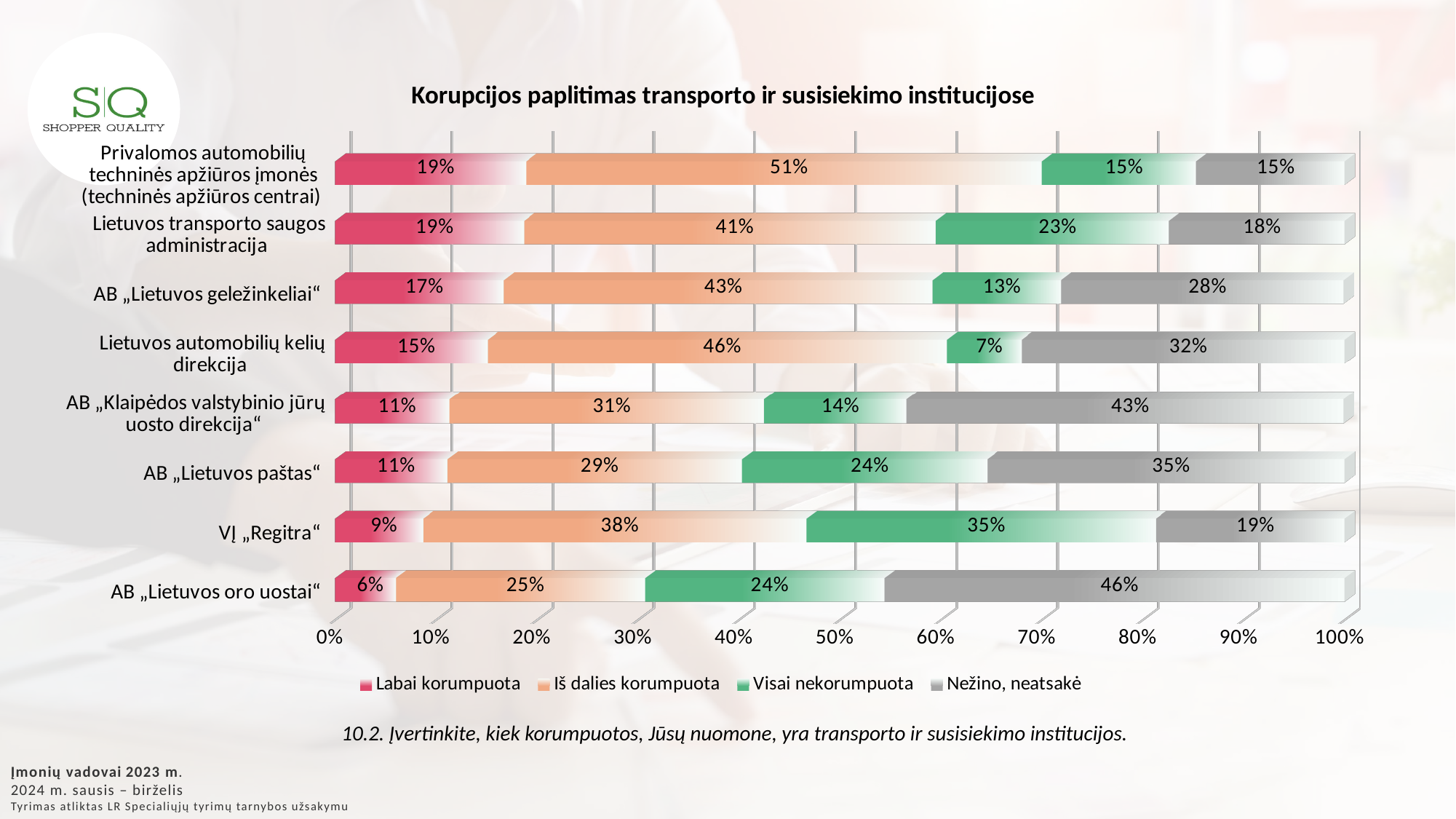
What is the combined total of "Labai korumpuota" and "Iš dalies korumpuota" for AB „Klaipėdos valstybinio jūrų uosto direkcija“? 42% What is the difference between the "Iš dalies korumpuota" values for Lietuvos automobilių kelių direkcija and AB „Lietuvos paštas“? 17% How many institutions (categories) are shown in the chart? 8 What kind of chart is shown on the slide? Stacked bar chart Which institution has the highest "Nežino, neatsakė" value? AB „Lietuvos oro uostai“ Which institution has the lowest "Labai korumpuota" value? AB „Lietuvos oro uostai“ What is the "Visai nekorumpuota" value for VĮ „Regitra“? 35% What is the "Nežino, neatsakė" value for AB „Lietuvos oro uostai“? 46% What is the "Iš dalies korumpuota" value for Privalomos automobilių techninės apžiūros įmonės? 51% Which is larger: the "Visai nekorumpuota" value for Lietuvos transporto saugos administracija or for AB „Lietuvos geležinkeliai“? Lietuvos transporto saugos administracija How many series does the legend list? 4 What is the title of the chart? Korupcijos paplitimas transporto ir susisiekimo institucijose